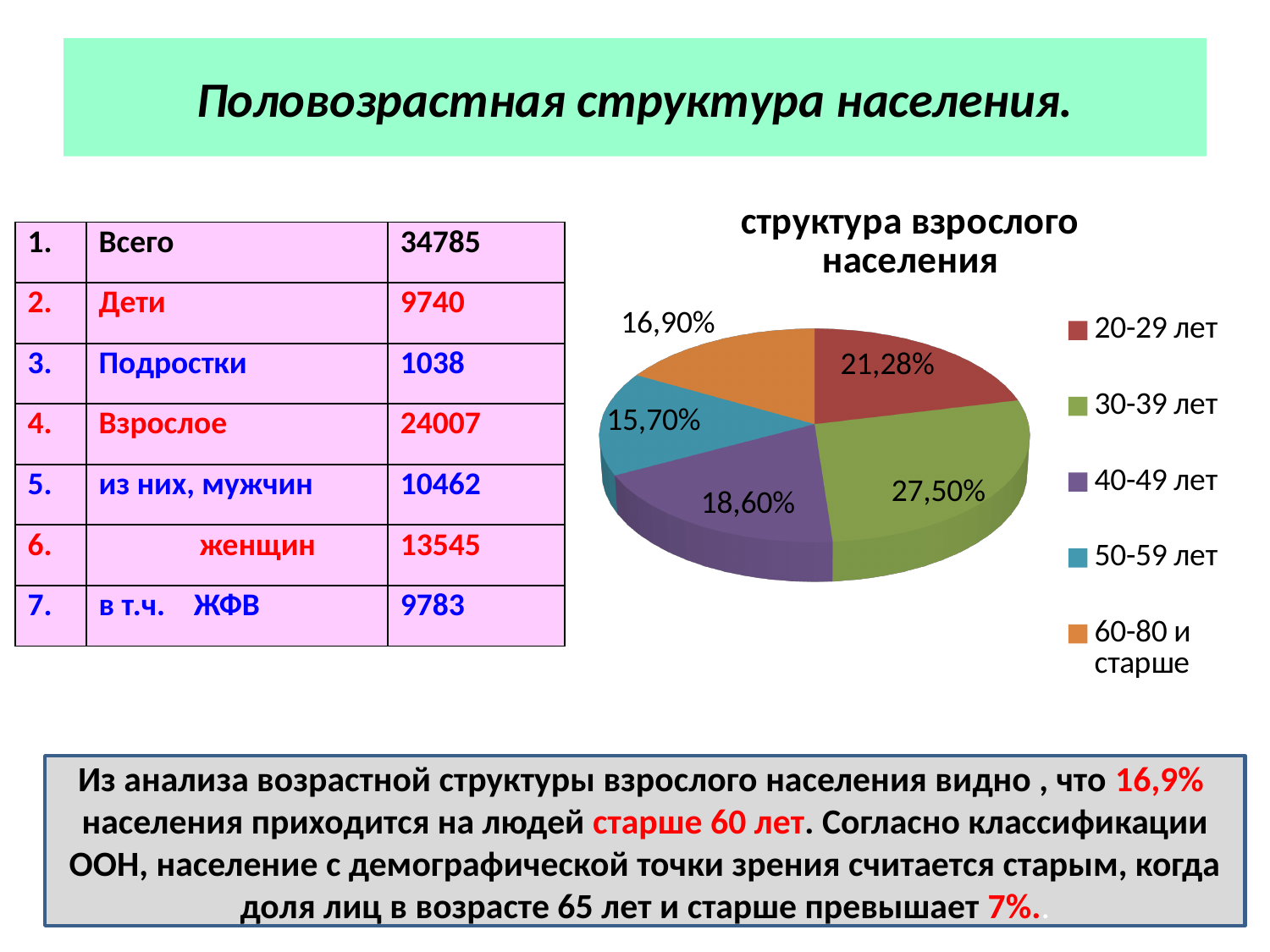
Which legend entry is shown in orange? 60-80 и старше What share of the adult population is aged 50-59 лет? 15,70% Which age group has the smallest share of the adult population? 50-59 лет What share of the adult population is in the 60-80 и старше group? 16,90% Which age group has the largest share of the adult population? 30-39 лет How many slices does the pie chart have? 5 What is the title of the chart? структура взрослого населения What share of the adult population is aged 30-39 лет? 27,50% What is the difference between the shares of the 30-39 лет and 20-29 лет groups? 6,22% Which group has a larger share: 40-49 лет or 60-80 и старше? 40-49 лет What share of the adult population is aged 20-29 лет? 21,28% What type of chart is shown on the slide? pie chart